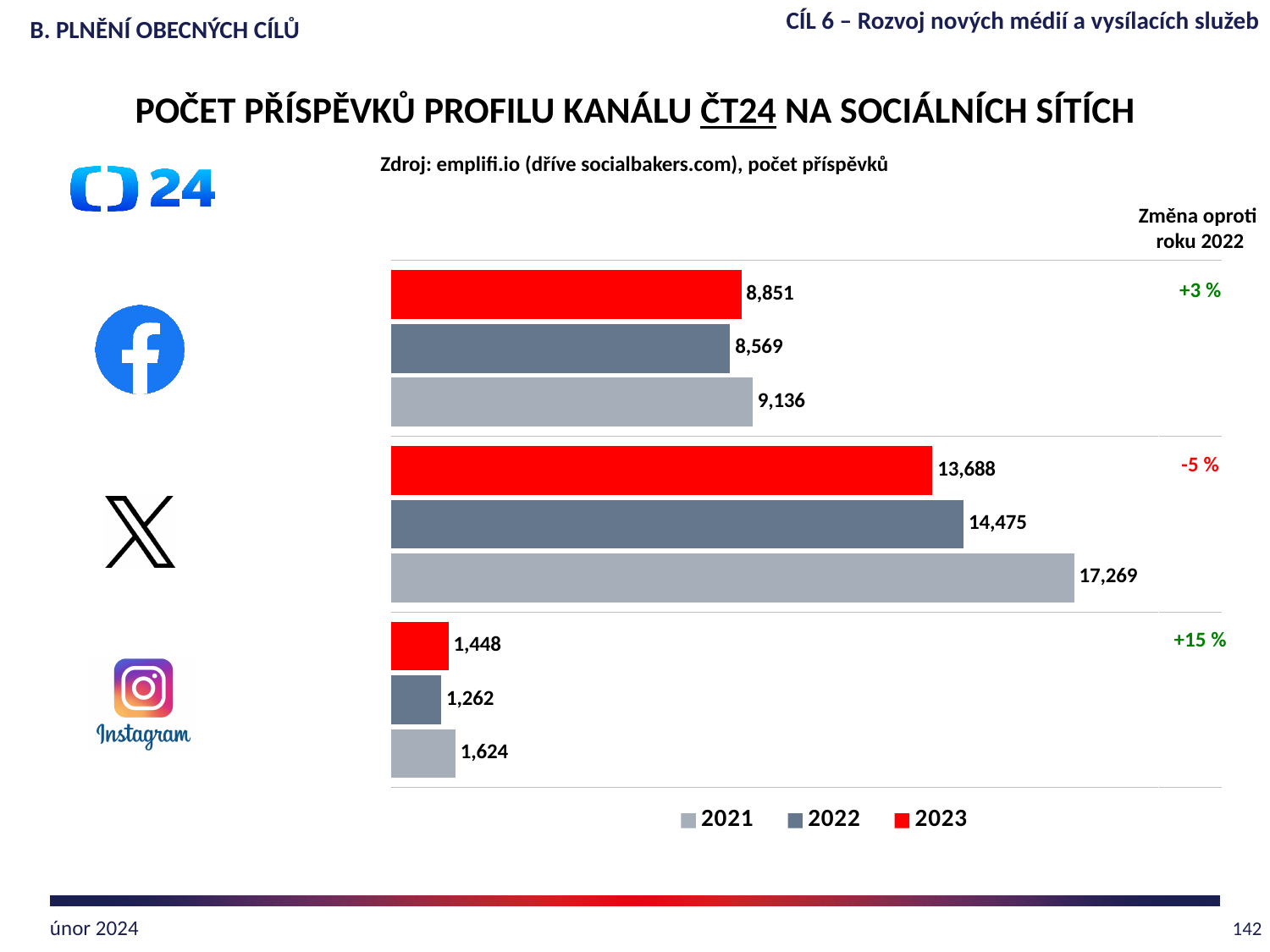
What is the number of posts on X in 2021? 17,269 How many series does the legend list? 3 What is the number of posts on Instagram in 2022? 1,262 Which colour represents the year 2023 in the legend? red Which is larger: the number of posts on Facebook in 2021 or in 2022? 2021 What is the difference between the number of posts on X in 2022 and in 2023? 787 What is the number of posts on Facebook in 2023? 8,851 What is the percentage change for Instagram compared to 2022, as shown on the slide? +15 % Which platform has the highest number of posts in 2023? X What kind of chart is shown on the slide? bar chart Which platform has the lowest number of posts in 2021? Instagram How many platforms (categories) are shown in the chart? 3